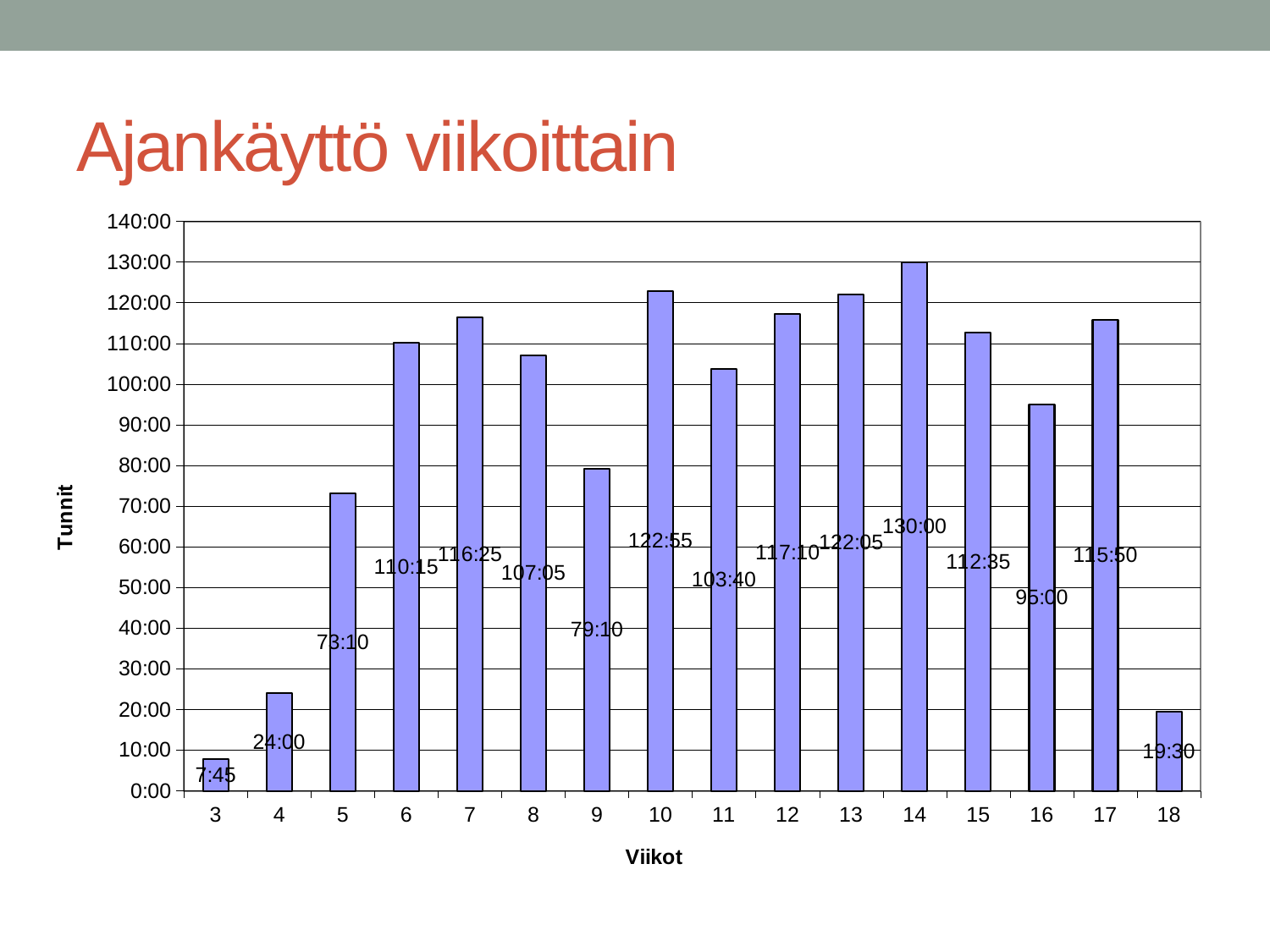
What is the value for week 14? 130:00 What is the difference between the values for week 4 and week 18? 4:30 What is the value for week 9? 79:10 Which week has the lowest value? 3 How many weeks are shown on the x axis? 16 What kind of chart is shown on the slide? bar chart What is the value for week 18? 19:30 What is the difference between the values for week 14 and week 16? 35:00 What is the label of the y axis? Tunnit Which week has the highest value? 14 Is the value for week 16 greater or less than 100:00? less Which is larger, the value for week 7 or the value for week 8? week 7